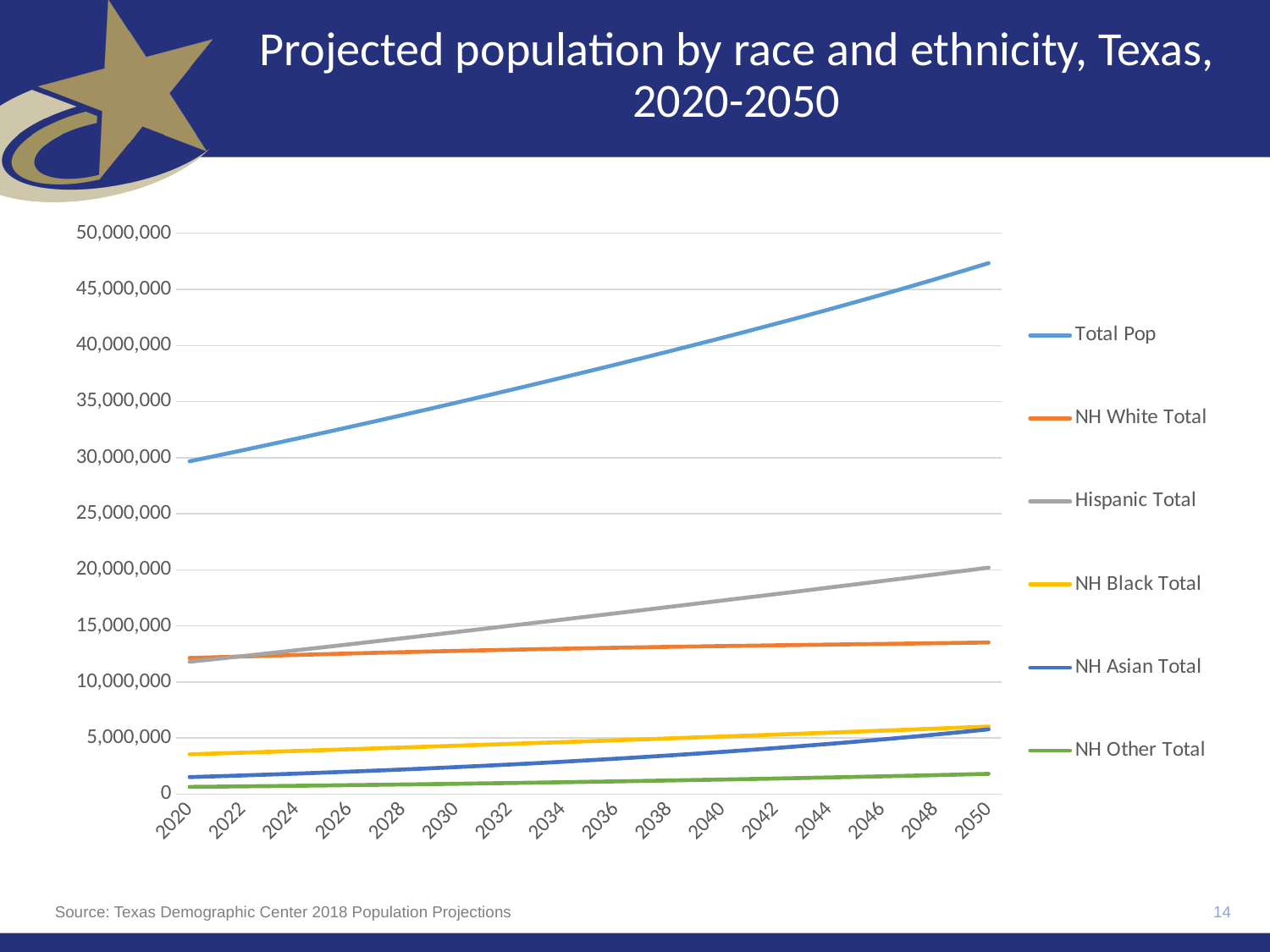
What is the title of the chart? Projected population by race and ethnicity, Texas, 2020-2050 Is the value for NH Other Total in 2050 greater or less than 5,000,000? less Is the value for NH White Total in 2050 greater or less than 15,000,000? less Is the value for Hispanic Total in 2050 greater or less than 15,000,000? greater In 2050, which is larger: Hispanic Total or NH White Total? Hispanic Total What kind of chart is shown on the slide? line chart How many series does the legend list? 6 Which series has the lowest value in 2050? NH Other Total In 2020, which is larger: NH Black Total or NH Asian Total? NH Black Total How many year labels are shown on the x axis? 16 Does the Total Pop line rise or fall from 2020 to 2050? rise